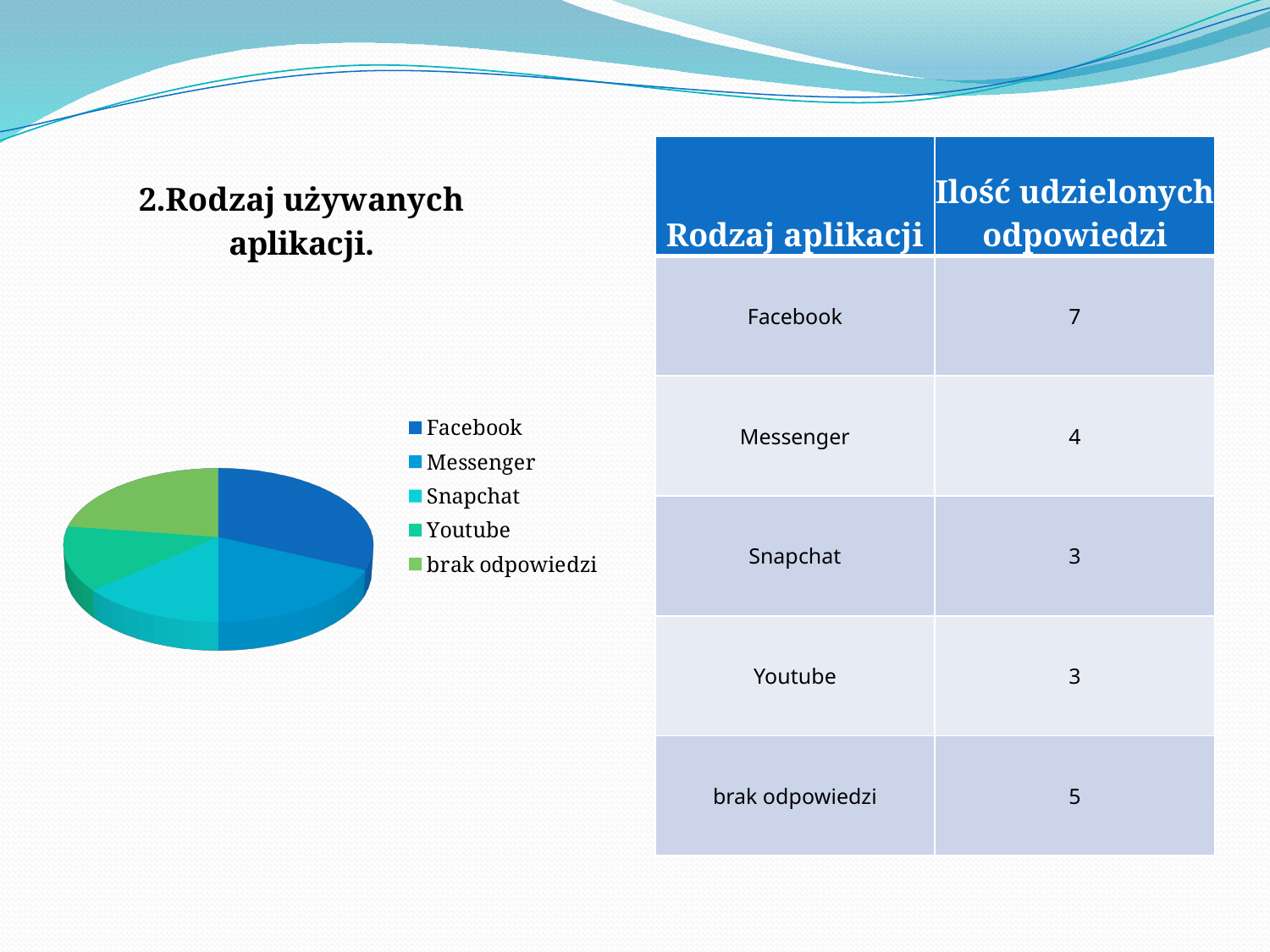
Which is larger in the pie chart, the Facebook slice or the Messenger slice? Facebook How many categories does the pie chart show? 5 According to the slide, how many responses does Facebook have? 7 Which is larger in the pie chart, the brak odpowiedzi slice or the Snapchat slice? brak odpowiedzi What kind of chart is shown on the slide? pie chart Which category has the largest slice in the pie chart? Facebook According to the slide, how many responses does Messenger have? 4 What is the difference between the number of responses for Facebook and for Messenger? 3 What is the title of the chart on the slide? 2.Rodzaj używanych aplikacji. How many entries does the pie chart's legend list? 5 According to the slide, how many responses does brak odpowiedzi have? 5 Which legend entry is listed first in the pie chart's legend? Facebook